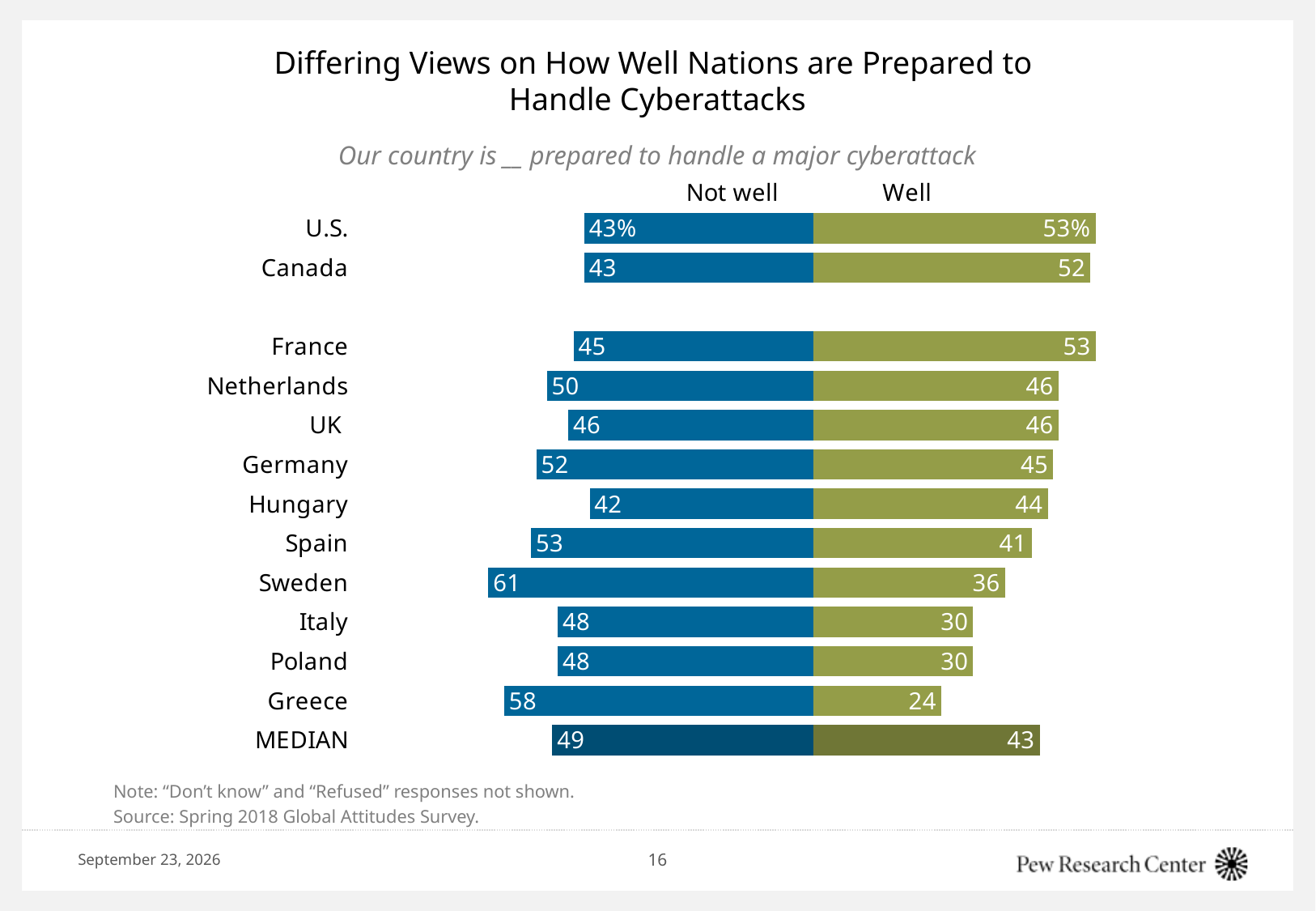
How many countries (excluding the MEDIAN row) are shown in the chart? 12 What is the difference between the 'Not well' and 'Well' values for Greece? 34 Which country has the lowest 'Well' value? Greece Which is larger for Germany, the 'Not well' value or the 'Well' value? Not well What is the 'Well' value for Greece? 24 What is the MEDIAN value for 'Not well'? 49 What kind of chart is shown on the slide? Bar chart How many series does the chart show? 2 What is the 'Well' value for the U.S.? 53% What percentage of respondents in Sweden say their country is not well prepared to handle a major cyberattack? 61 Which colour represents the 'Well' series? Green Which country has the highest 'Not well' value? Sweden